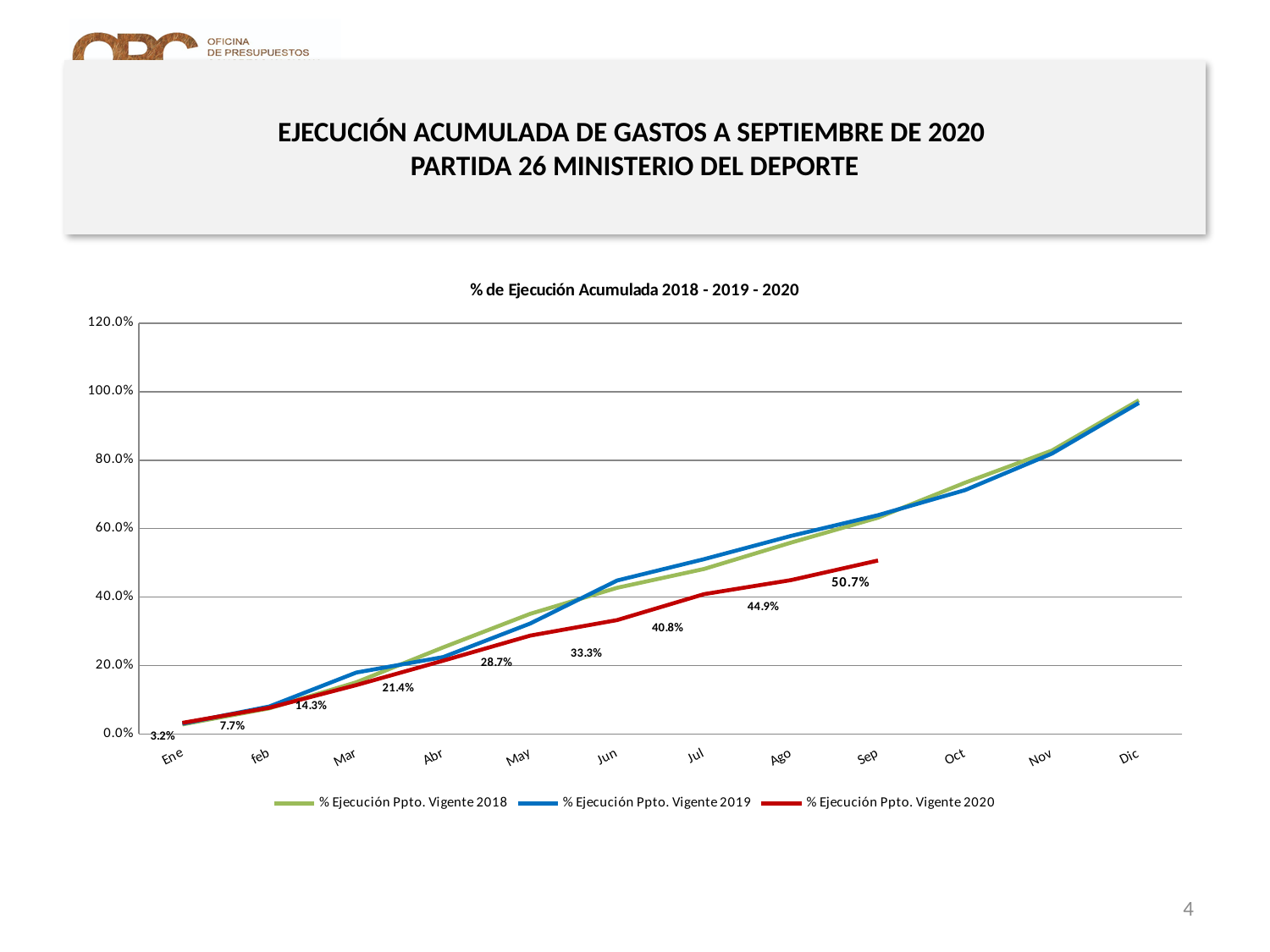
What is the difference between the % Ejecución Ppto. Vigente 2020 values for Jul and Jun? 7.5% What kind of chart is shown on the slide? line chart Does the % Ejecución Ppto. Vigente 2020 series rise or fall from Ene to Sep? rise What is the difference between the % Ejecución Ppto. Vigente 2020 values for Sep and Ago? 5.8% How many months are shown on the x axis? 12 In Sep, which is larger: % Ejecución Ppto. Vigente 2019 or % Ejecución Ppto. Vigente 2020? % Ejecución Ppto. Vigente 2019 What is the value of % Ejecución Ppto. Vigente 2020 in May? 28.7% What is the title of the chart? % de Ejecución Acumulada 2018 - 2019 - 2020 What is the value of % Ejecución Ppto. Vigente 2020 in Sep? 50.7% Is the value for % Ejecución Ppto. Vigente 2019 in Dic greater or less than 80.0%? greater How many series does the legend list? 3 What is the value of % Ejecución Ppto. Vigente 2020 in Ene? 3.2%